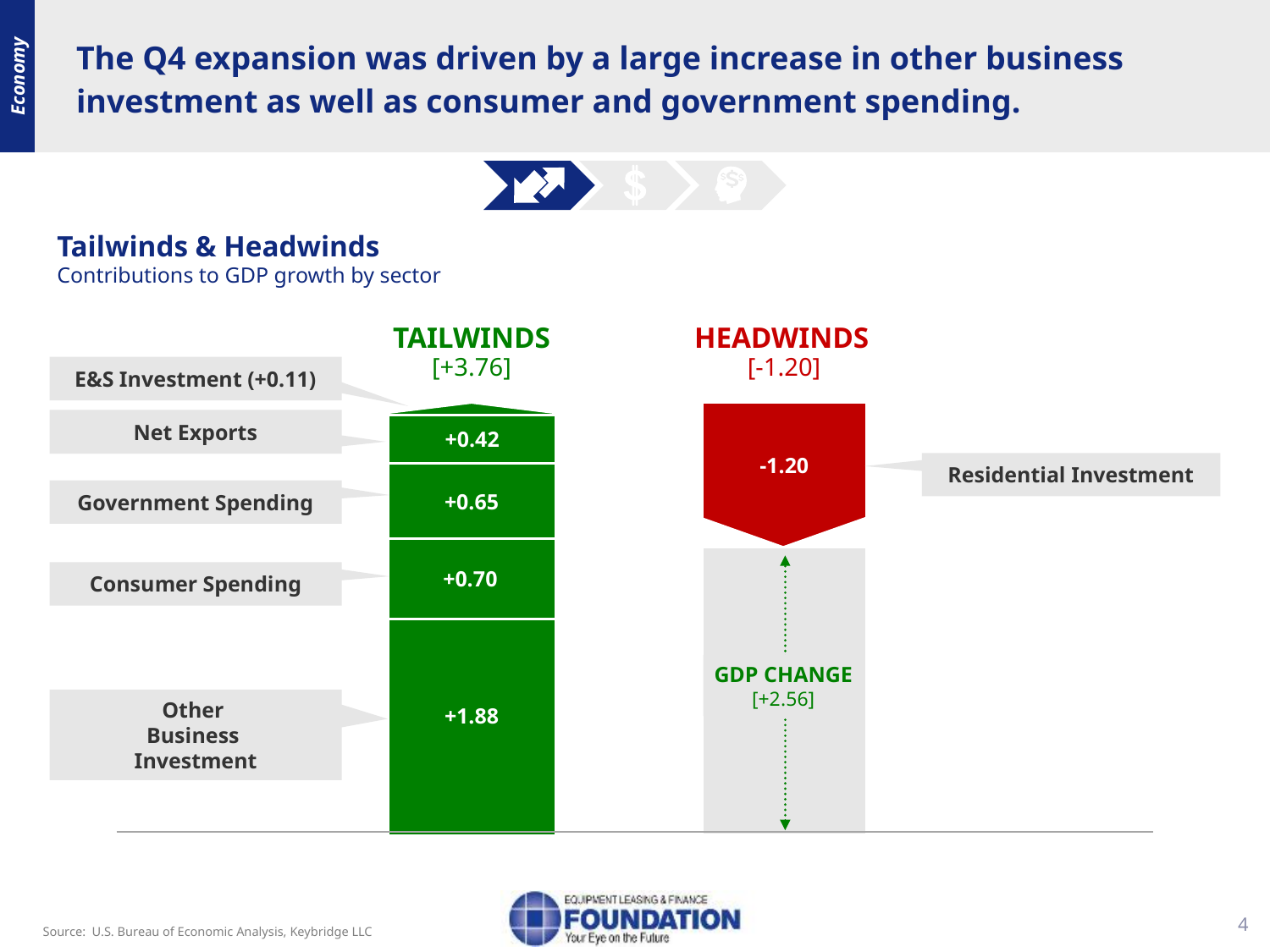
What is the contribution of Residential Investment to GDP growth? -1.20 What is the contribution of Net Exports to GDP growth? +0.42 What is the title of the chart? Tailwinds & Headwinds Which sector has the largest positive contribution to GDP growth? Other Business Investment What is the contribution of Other Business Investment to GDP growth? +1.88 Which sector has the smallest positive contribution among the tailwinds? E&S Investment What is the total of the tailwinds stacked bar? +3.76 What is the contribution of Government Spending to GDP growth? +0.65 What is the contribution of Consumer Spending to GDP growth? +0.70 What is the contribution of E&S Investment to GDP growth? +0.11 What is the difference between the contributions of Other Business Investment and Consumer Spending? 1.18 Which is larger, the contribution of Government Spending or Net Exports? Government Spending